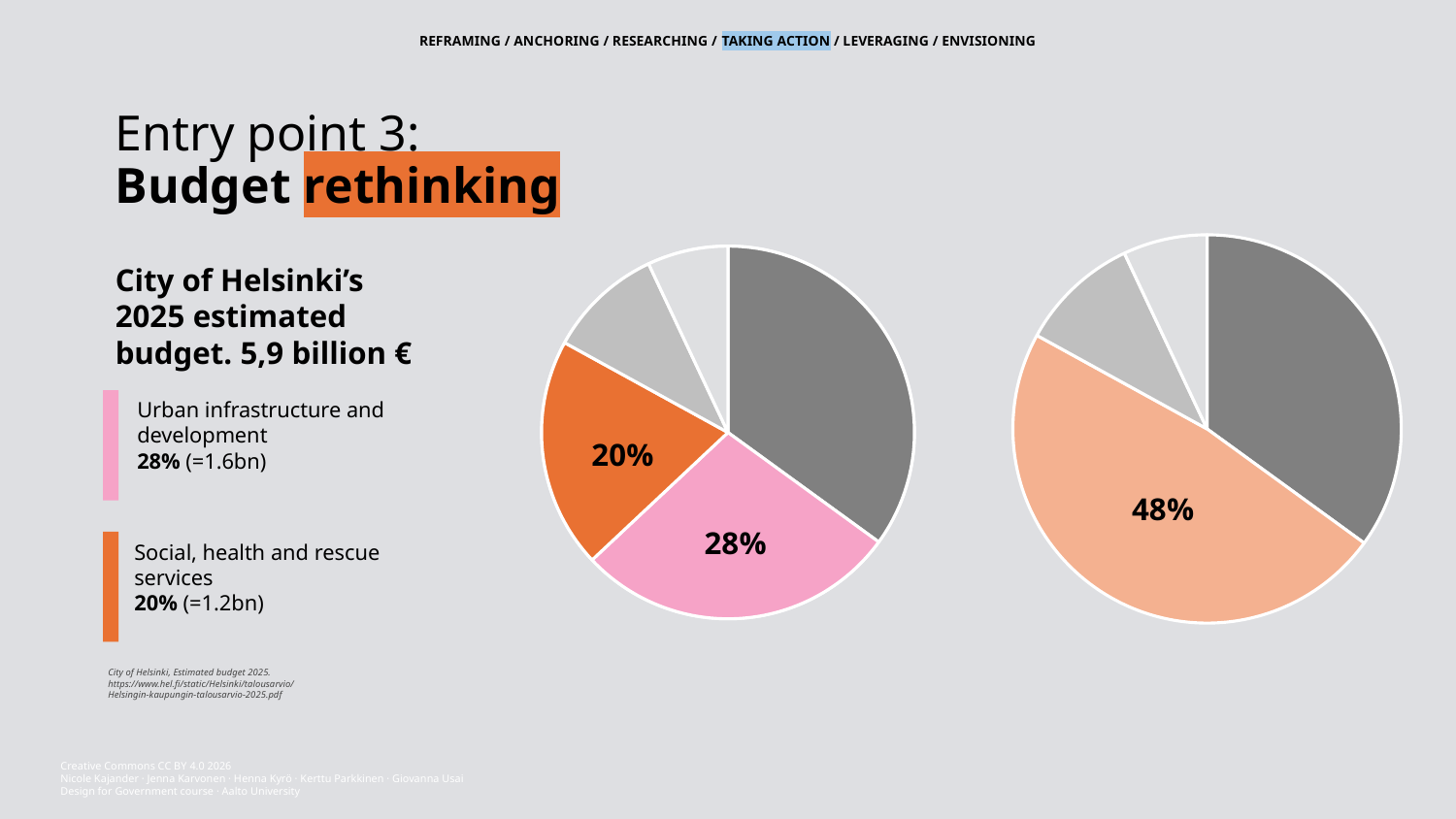
In the left pie chart, what is the difference between the Urban infrastructure and development share and the Social, health and rescue services share? 8% In the right pie chart, which slice is the largest? the 48% slice In the left pie chart, what share is shown for Social, health and rescue services? 20% How many slices does the right pie chart have? 4 In the left pie chart, what share is shown for Urban infrastructure and development? 28% In the left pie chart, which is larger: Urban infrastructure and development or Social, health and rescue services? Urban infrastructure and development According to the slide text, what is the City of Helsinki's 2025 estimated budget? 5,9 billion € How many slices does the left pie chart have? 5 In the left pie chart, what is the combined share of the two labelled slices (28% and 20%)? 48% In the right pie chart, is the dark grey slice greater or less than 50%? less In the right pie chart, what percentage is printed on the large salmon-coloured slice? 48% What kind of chart is shown on the left of the slide? pie chart